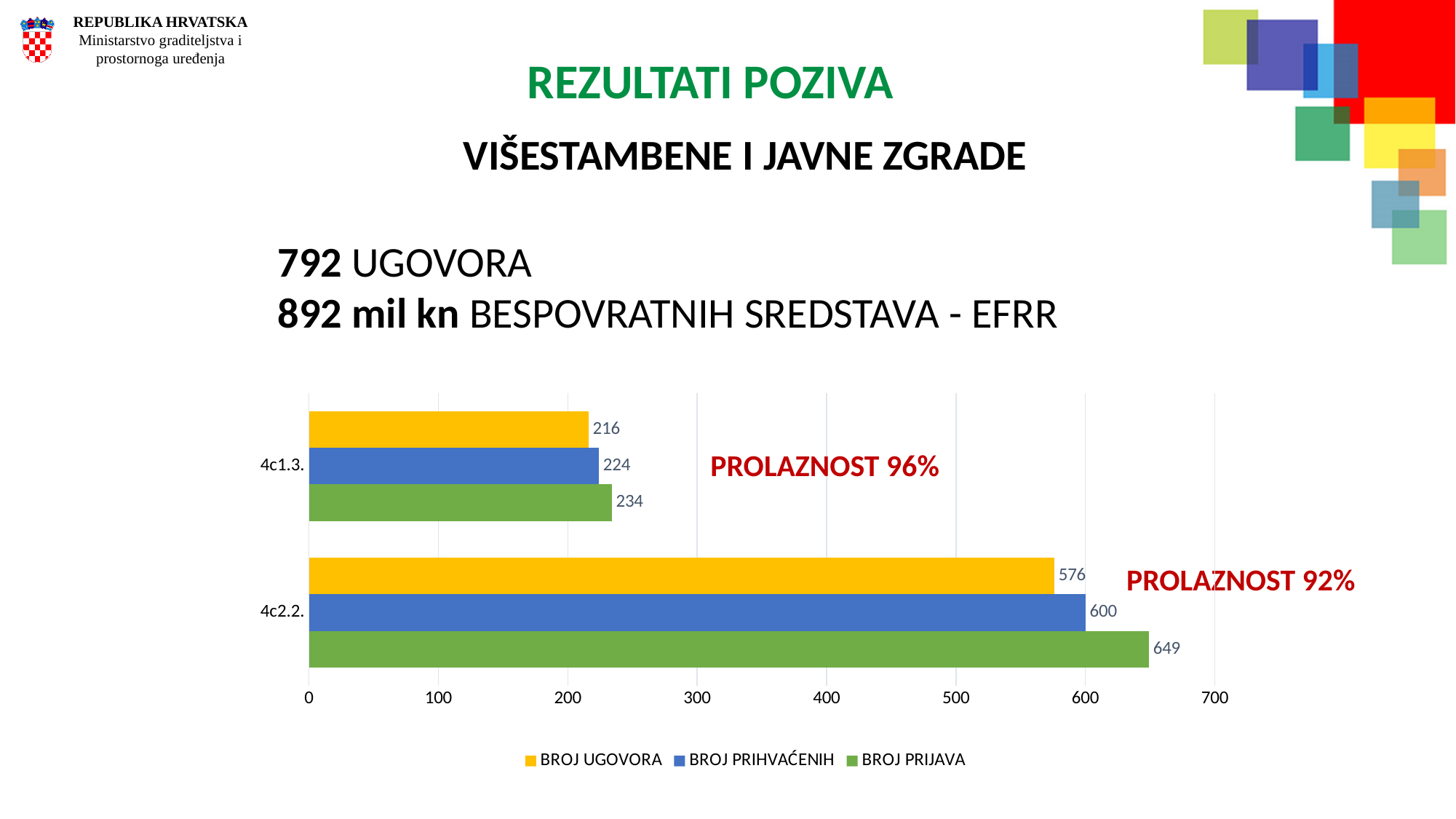
How many series does the legend list? 3 What is the difference between BROJ PRIJAVA and BROJ PRIHVAĆENIH for 4c2.2.? 49 What kind of chart is shown on the slide? Bar chart Which is larger for 4c1.3.: BROJ PRIHVAĆENIH or BROJ UGOVORA? BROJ PRIHVAĆENIH What is the value of BROJ PRIHVAĆENIH for 4c2.2.? 600 What is the value of BROJ PRIJAVA for 4c1.3.? 234 What is the difference between BROJ UGOVORA for 4c2.2. and 4c1.3.? 360 What is the value of BROJ PRIJAVA for 4c2.2.? 649 How many categories are shown on the chart? 2 Which category has the highest BROJ UGOVORA value? 4c2.2. Which category has the lowest BROJ PRIJAVA value? 4c1.3. What is the value of BROJ UGOVORA for 4c1.3.? 216